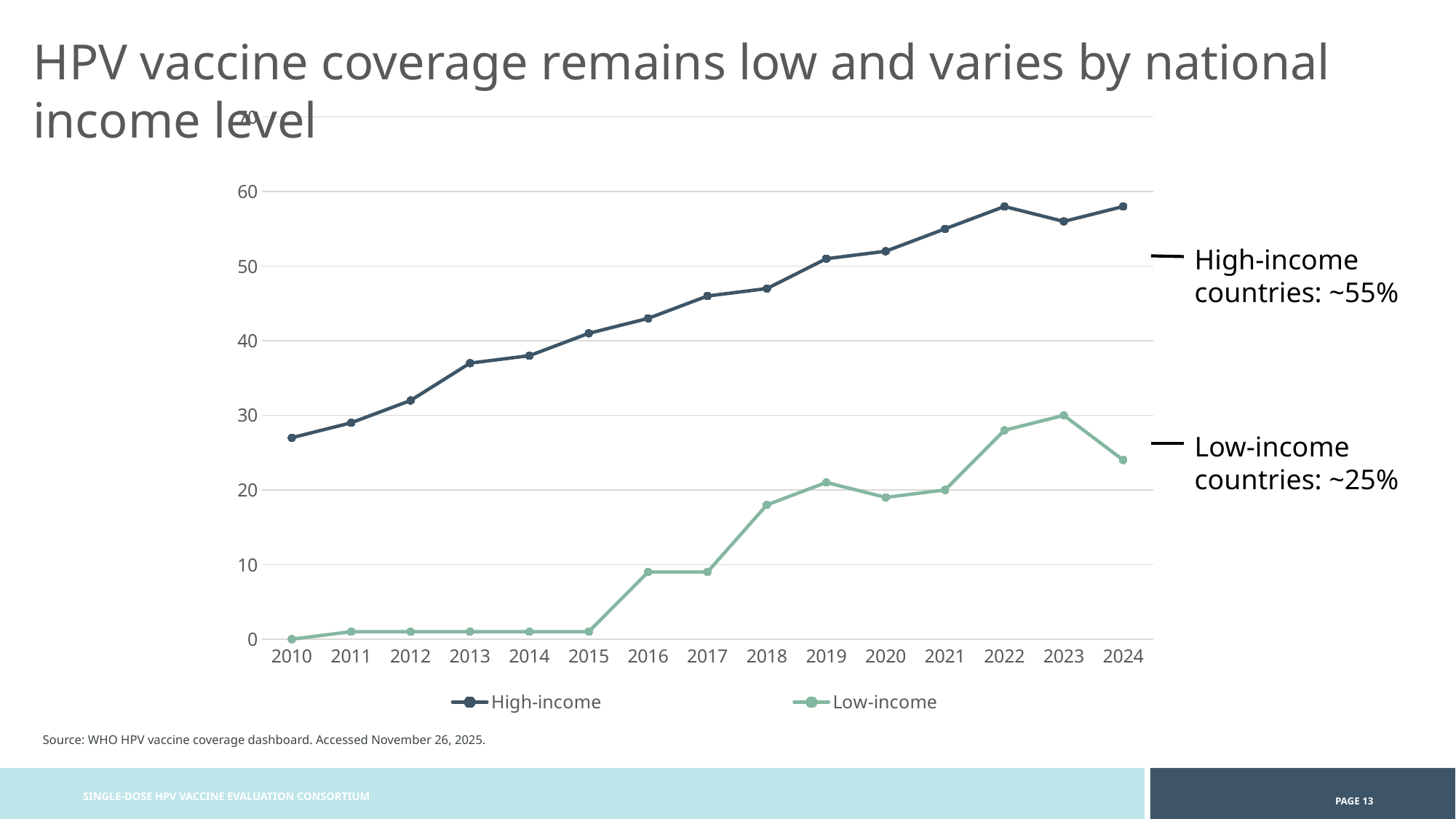
In which year is the High-income series at its lowest value? 2010 In which year does the Low-income series reach its highest value? 2023 Is the Low-income value for 2022 greater or less than 20? greater How many years are plotted along the x axis? 15 Is the High-income value for 2024 greater or less than 50? greater Which series has the larger value in 2024, High-income or Low-income? High-income What kind of chart is shown on the slide? line chart Is the High-income value for 2010 greater or less than 30? less Does the High-income series generally rise or fall from 2010 to 2024? rise How many series does the legend list? 2 What is the Low-income value for 2010? 0